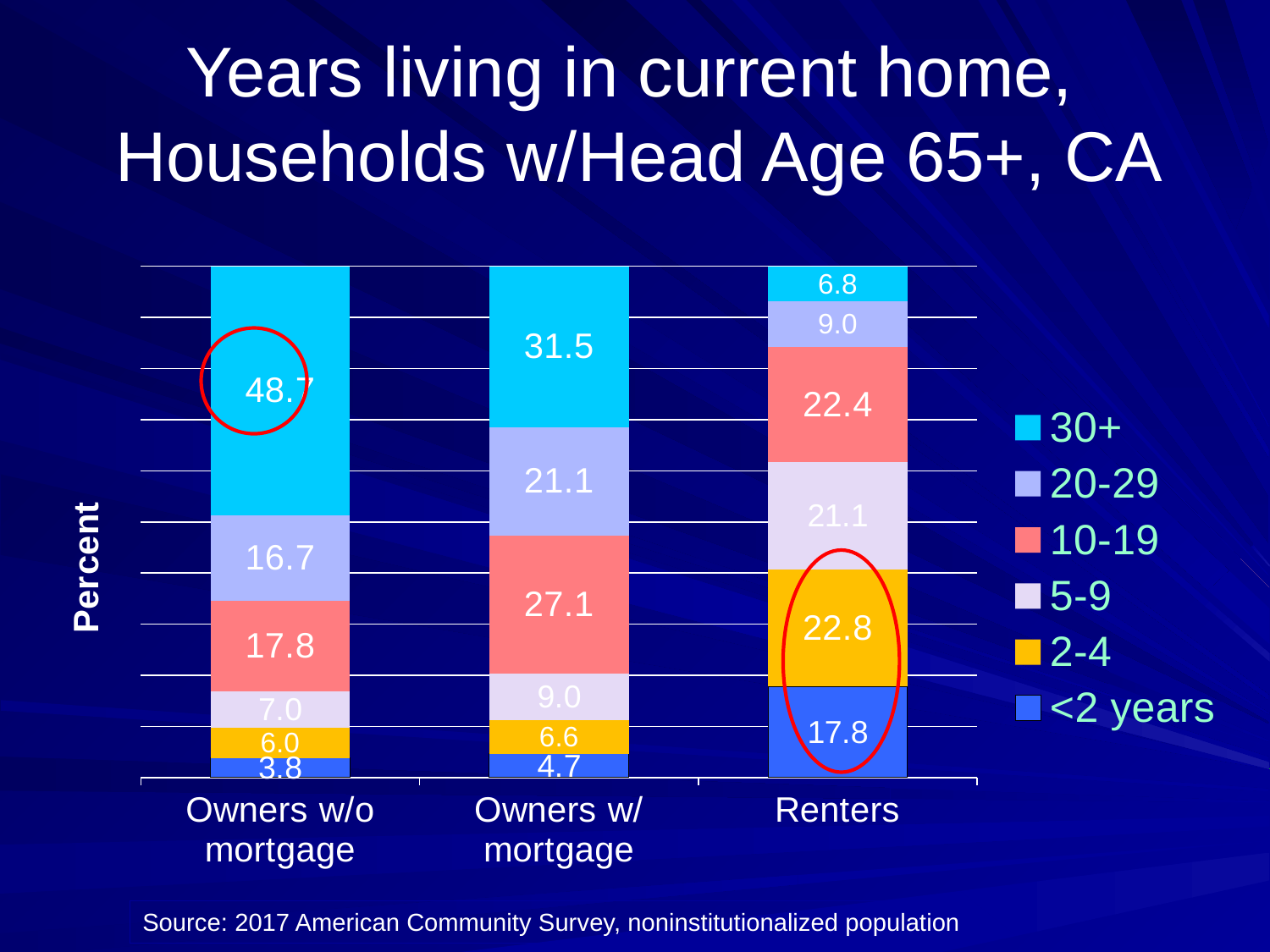
What kind of chart is shown on the slide? Stacked bar chart What is the value for the 30+ segment of the Renters bar? 6.8 How many household categories are shown on the x axis? 3 Which household category has the highest value for the 30+ series? Owners w/o mortgage What is the value for the 10-19 segment of the Owners w/ mortgage bar? 27.1 How many series does the legend list? 6 What is the value for the 20-29 segment of the Owners w/o mortgage bar? 16.7 What is the value for the <2 years segment of the Renters bar? 17.8 In the Renters bar, what is the difference between the 2-4 segment and the <2 years segment? 5.0 In the Owners w/ mortgage bar, which is larger: the 10-19 segment or the 20-29 segment? 10-19 What is the total of all segments in the Owners w/ mortgage bar? 100.0 Which household category has the lowest value for the <2 years series? Owners w/o mortgage